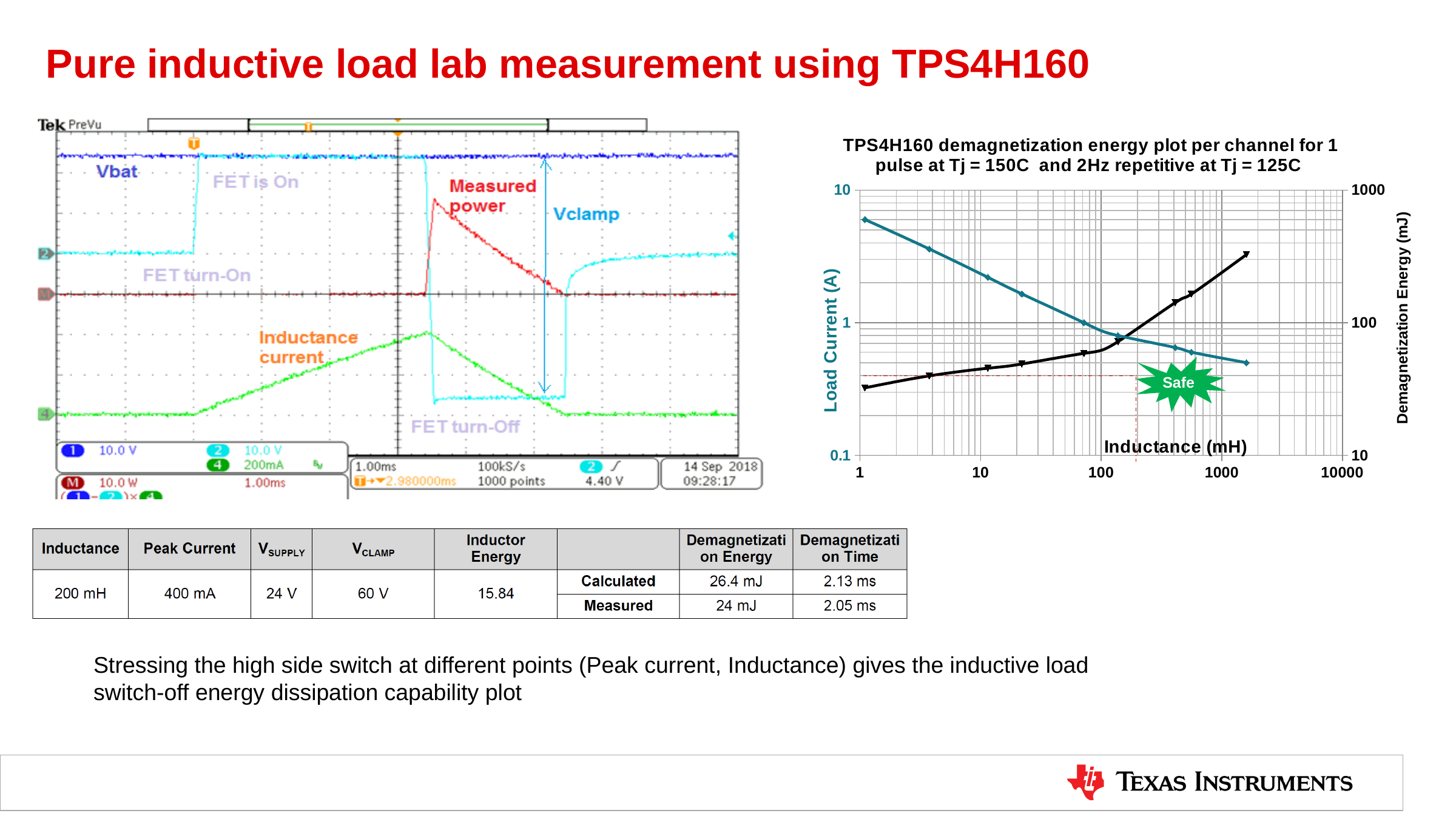
In the TPS4H160 demagnetization energy plot, which is larger at 1 mH inductance: the load current in A or the load current at 100 mH? Load current at 1 mH In the TPS4H160 demagnetization energy plot, is the load current at 1000 mH inductance greater or less than 1 A? less In the TPS4H160 demagnetization energy plot, what is the lowest value shown on the left y axis (Load Current)? 0.1 In the TPS4H160 demagnetization energy plot, is the demagnetization energy at 1 mH inductance greater or less than 100 mJ? less In the TPS4H160 demagnetization energy plot, what is the label of the right-hand y axis? Demagnetization Energy (mJ) In the TPS4H160 demagnetization energy plot, what kind of chart is used? Line chart In the TPS4H160 demagnetization energy plot, what is the label of the x axis? Inductance (mH) In the TPS4H160 demagnetization energy plot, does the Load Current line rise or fall as inductance increases? Fall In the TPS4H160 demagnetization energy plot, how many lines are plotted? 2 In the TPS4H160 demagnetization energy plot, is the load current at 1 mH inductance greater or less than 1 A? greater In the TPS4H160 demagnetization energy plot, does the Demagnetization Energy line rise or fall as inductance increases? Rise